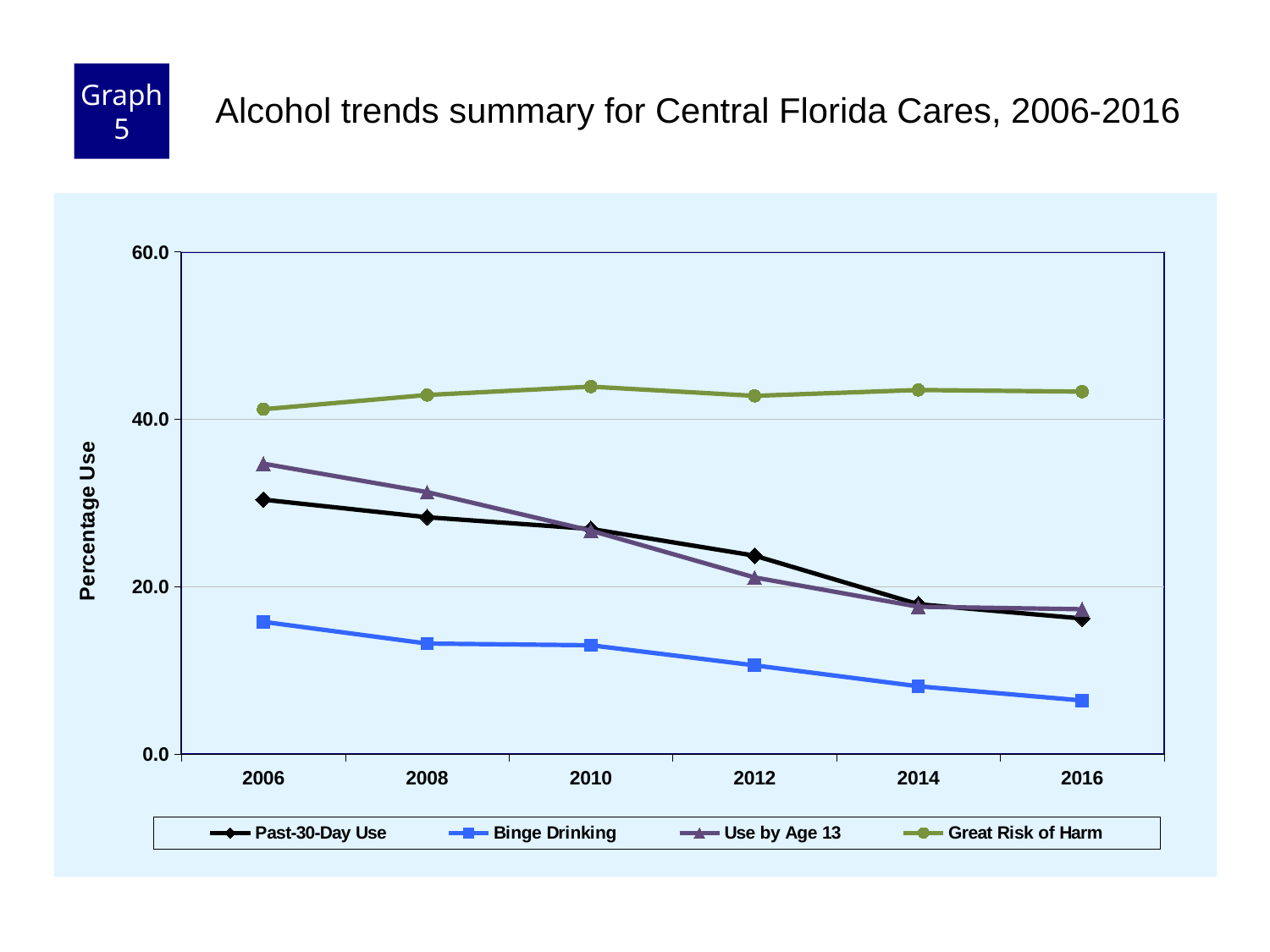
Which series has the highest value in 2016? Great Risk of Harm Is the value for Binge Drinking in 2016 greater or less than 20.0? less Which series has the lowest value in 2016? Binge Drinking Does the Binge Drinking series rise or fall from 2006 to 2016? fall Is the value for Use by Age 13 in 2006 greater or less than 40.0? less In 2006, which is larger: Use by Age 13 or Past-30-Day Use? Use by Age 13 How many years are plotted along the x axis? 6 What kind of chart is shown on the slide? line chart How many series does the legend list? 4 What is the label on the y axis? Percentage Use Is the value for Past-30-Day Use in 2006 greater or less than 20.0? greater